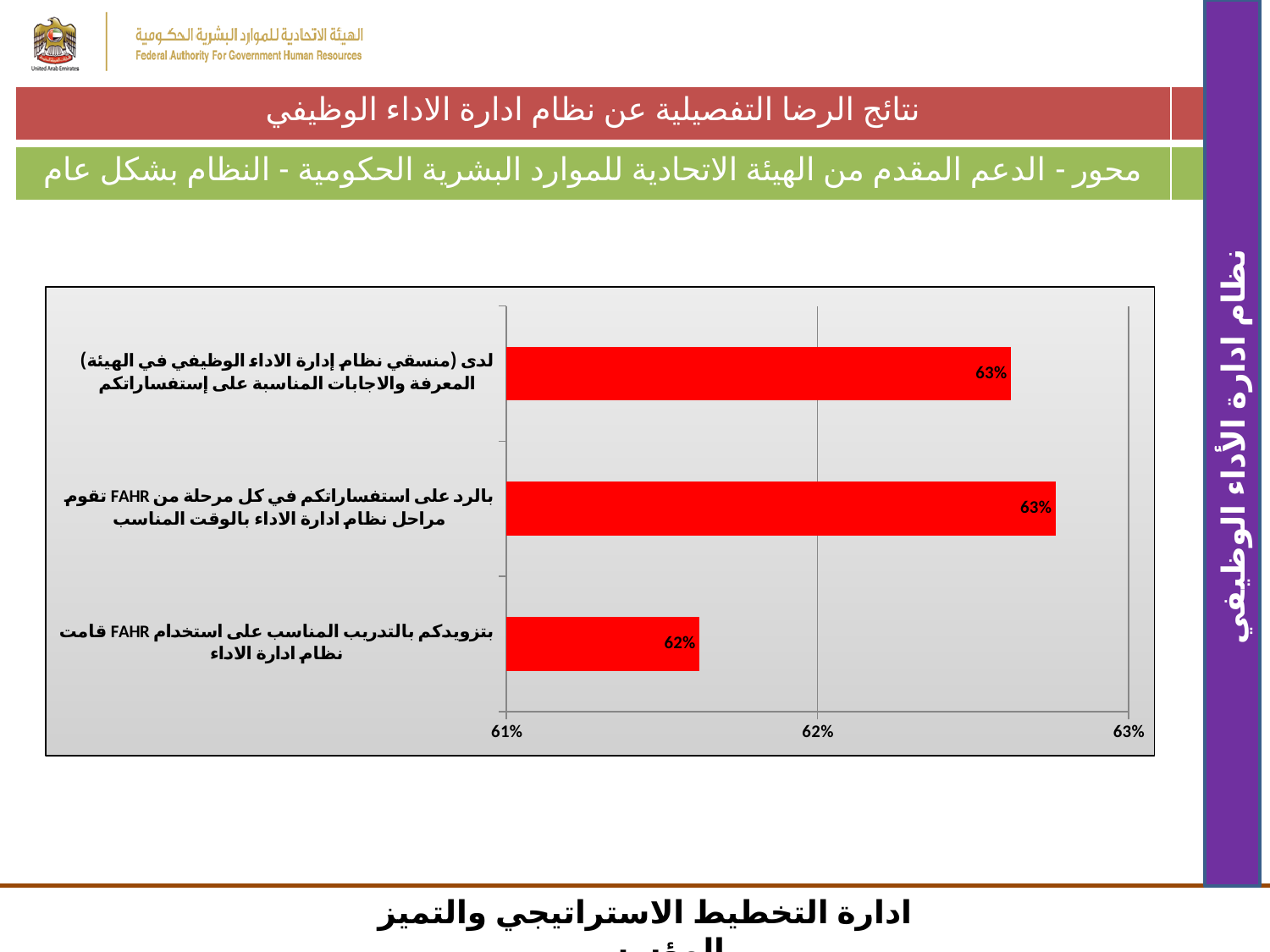
Which is larger: the value for FAHR providing suitable training (قامت FAHR بتزويدكم بالتدريب المناسب) or the value for FAHR responding to inquiries in a timely manner (تقوم FAHR بالرد على استفساراتكم بالوقت المناسب)? تقوم FAHR بالرد على استفساراتكم بالوقت المناسب What is the difference between the value for coordinators having the knowledge and appropriate answers (63%) and the value for FAHR providing suitable training (62%)? 1% What kind of chart is shown on the slide? bar chart What is the value for the category about FAHR responding to inquiries at every stage of the performance management system in a timely manner (تقوم FAHR بالرد على استفساراتكم في كل مرحلة من مراحل نظام ادارة الاداء بالوقت المناسب)? 63% Which category has the lowest value? قامت FAHR بتزويدكم بالتدريب المناسب على استخدام نظام ادارة الاداء What is the value for the category about the performance management system coordinators having the knowledge and appropriate answers to inquiries (لدى منسقي نظام إدارة الاداء الوظيفي في الهيئة المعرفة والاجابات المناسبة على إستفساراتكم)? 63% How many categories (bars) does the chart show? 3 Is the value for the category about FAHR providing suitable training greater or less than 61%? greater What colour are the bars in the chart? red Is the value for the category about FAHR responding to inquiries in a timely manner greater or less than 62%? greater What is the lowest value shown on the horizontal axis of the chart? 61% What is the value for the category about FAHR providing suitable training on using the performance management system (قامت FAHR بتزويدكم بالتدريب المناسب على استخدام نظام ادارة الاداء)? 62%